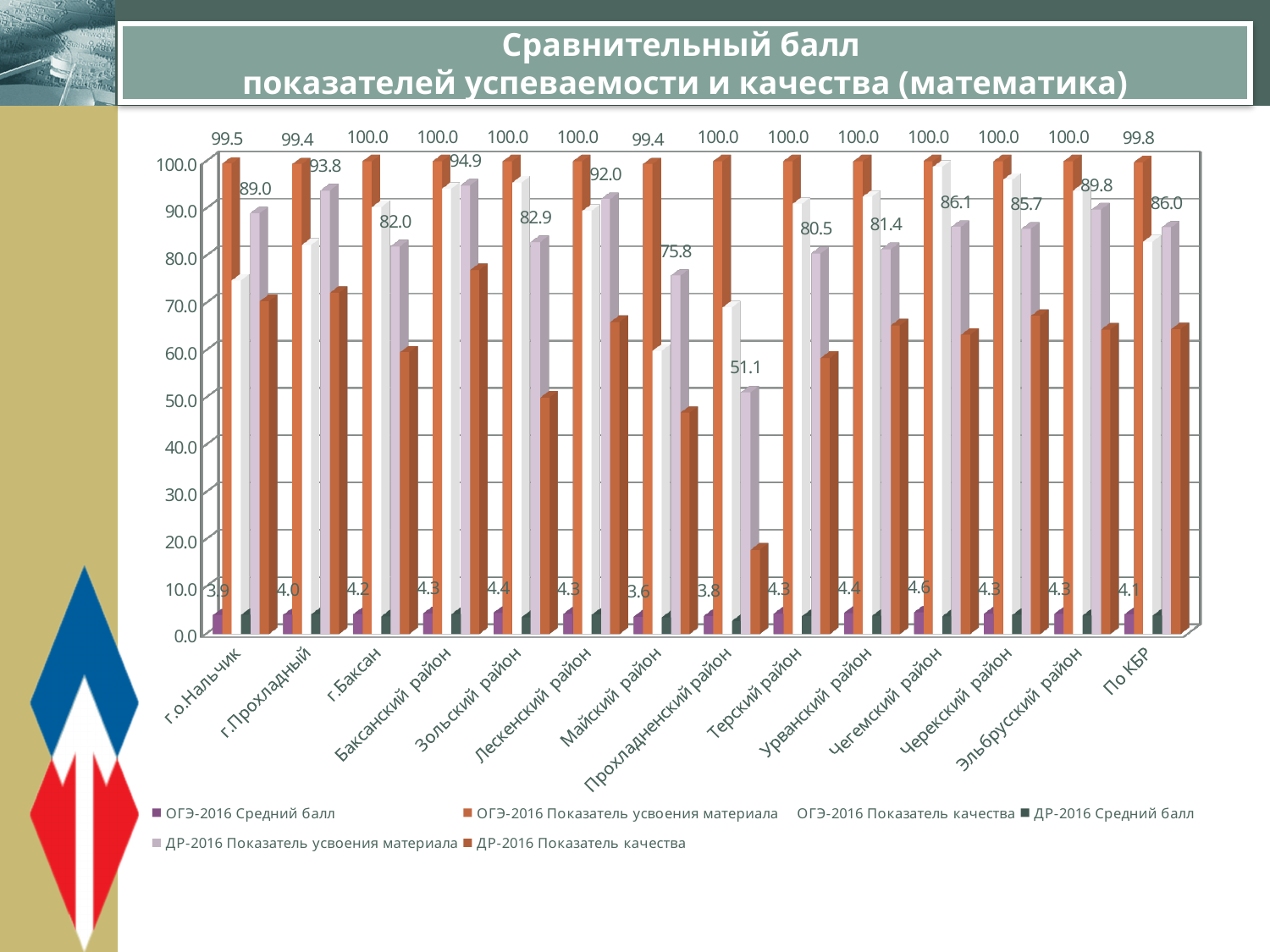
What is the ДР-2016 Показатель усвоения материала value for Прохладненский район? 51.1 Which category has the highest ДР-2016 Показатель усвоения материала? Баксанский район What is the difference between the ДР-2016 Показатель усвоения материала values for Баксанский район and г.Баксан? 12.9 Is the ОГЭ-2016 Показатель качества value for Прохладненский район greater or less than 60? greater What is the ОГЭ-2016 Средний балл value for Майский район? 3.6 How many categories are shown on the x axis? 14 What is the ОГЭ-2016 Показатель усвоения материала value for г.о.Нальчик? 99.5 How many series does the legend list? 6 Which category has the lowest ДР-2016 Показатель усвоения материала? Прохладненский район Which category has the highest ОГЭ-2016 Средний балл? Чегемский район Which has the larger ОГЭ-2016 Средний балл, Майский район or Прохладненский район? Прохладненский район What is the ОГЭ-2016 Показатель усвоения материала value for По КБР? 99.8